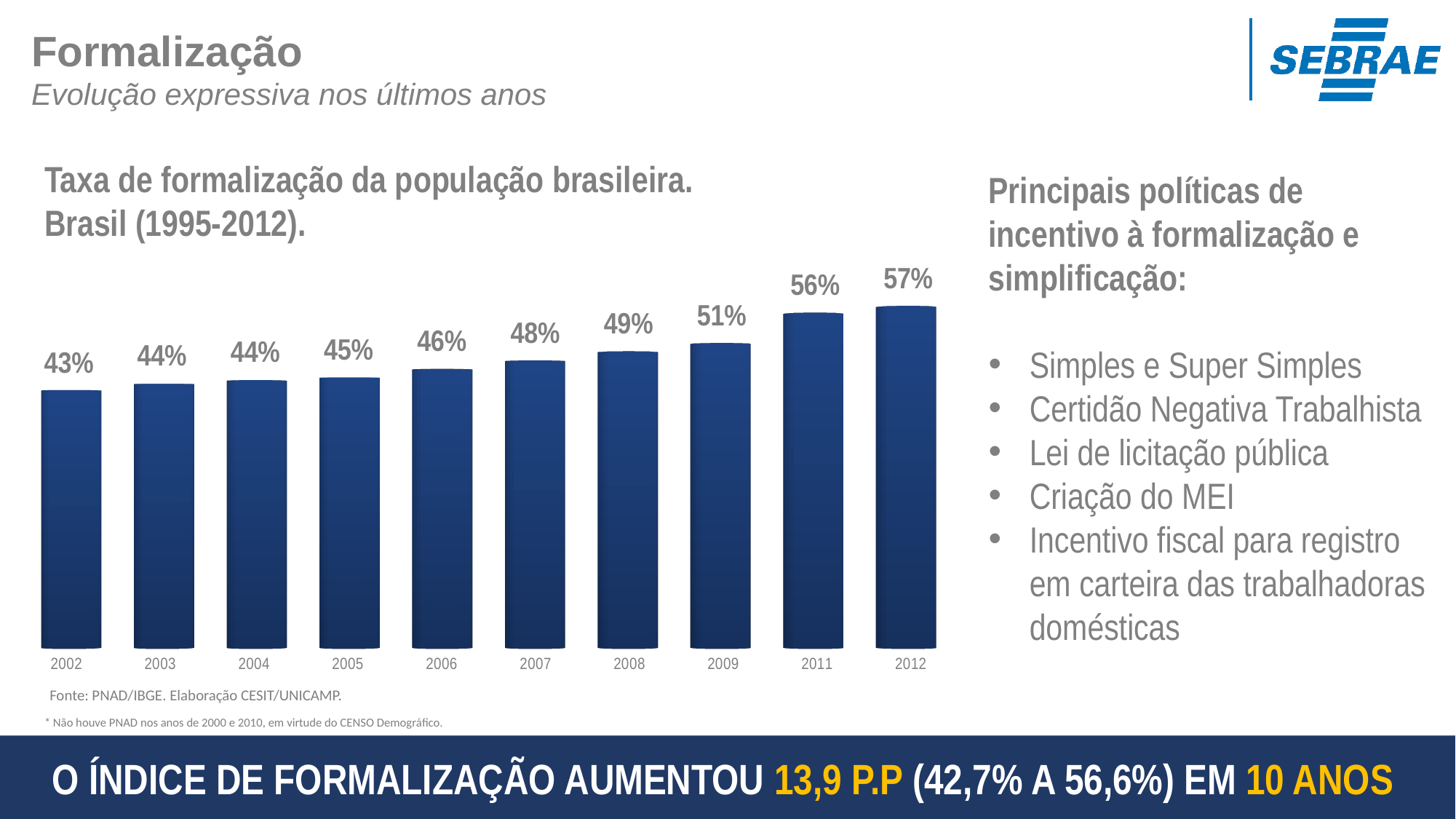
What is the difference in percentage points between the 2012 value and the 2002 value? 14 Do the values rise or fall from 2002 to 2012? Rise What is the formalization rate shown for 2012? 57% Which year is missing between 2009 and 2011 on the x axis? 2010 What is the formalization rate shown for 2002? 43% What type of chart is used to show the formalization rate? Bar chart Which year has the lowest formalization rate in the chart? 2002 What is the formalization rate shown for 2009? 51% Which is larger, the value for 2007 or the value for 2011? 2011 What is the difference in percentage points between the 2009 value and the 2008 value? 2 How many years (bars) are shown in the chart? 10 Which year has the highest formalization rate in the chart? 2012